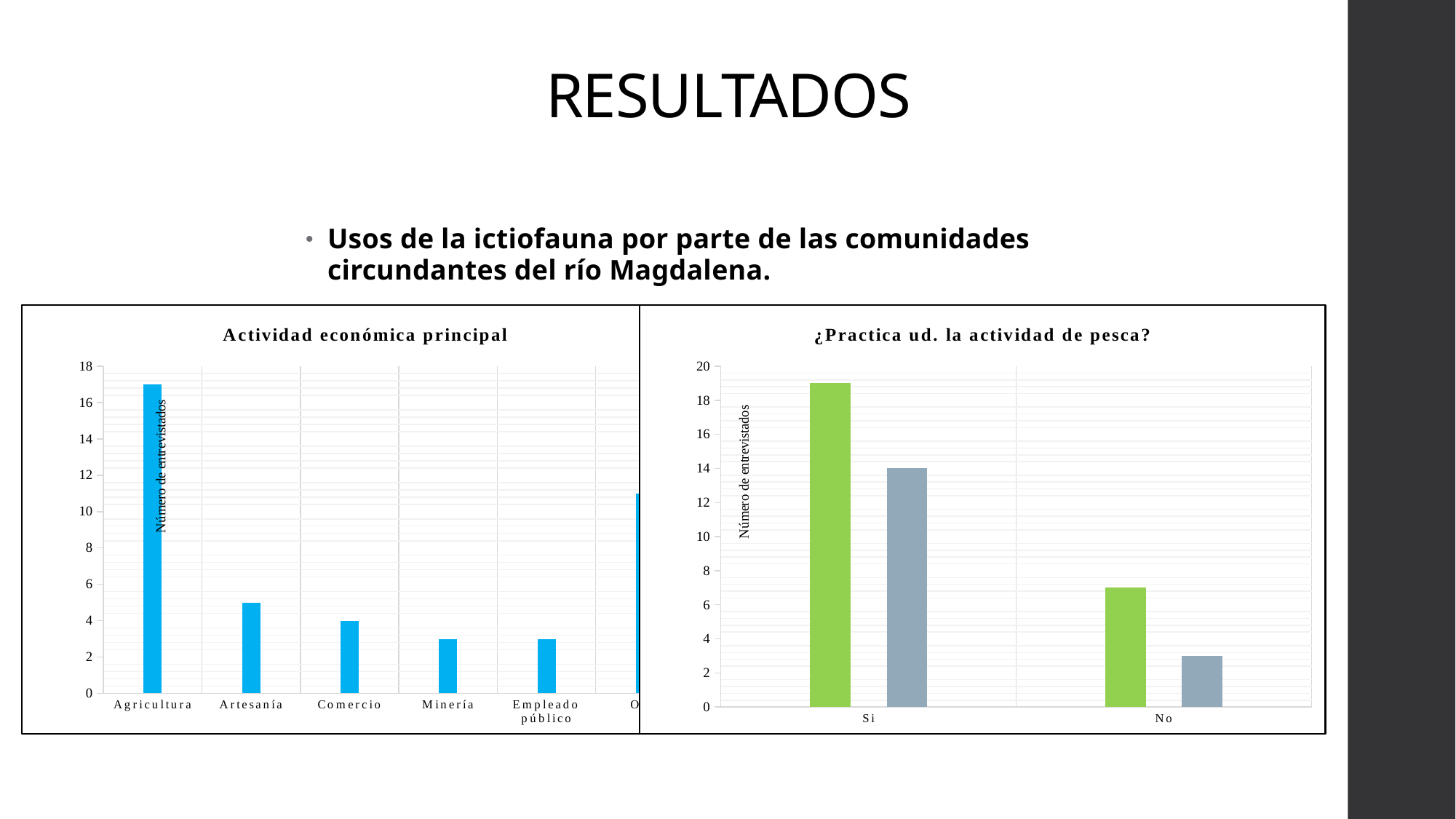
What is the y-axis label of the '¿Practica ud. la actividad de pesca?' chart? Número de entrevistados In the 'Actividad económica principal' chart, is the value for Minería greater or less than 4? less In the 'Actividad económica principal' chart, is the value for Agricultura greater or less than 16? greater How many categories are shown on the x axis of the '¿Practica ud. la actividad de pesca?' chart? 2 In the 'Actividad económica principal' chart, what is the value for Comercio? 4 What kind of chart is the 'Actividad económica principal' chart? bar chart In the 'Actividad económica principal' chart, which is larger, the value for Agricultura or the value for Artesanía? Agricultura What kind of chart is the '¿Practica ud. la actividad de pesca?' chart? bar chart In the '¿Practica ud. la actividad de pesca?' chart, is the green bar for Si greater or less than 18? greater In the '¿Practica ud. la actividad de pesca?' chart, what is the value of the grey bar for Si? 14 In the 'Actividad económica principal' chart, which category has the highest value? Agricultura